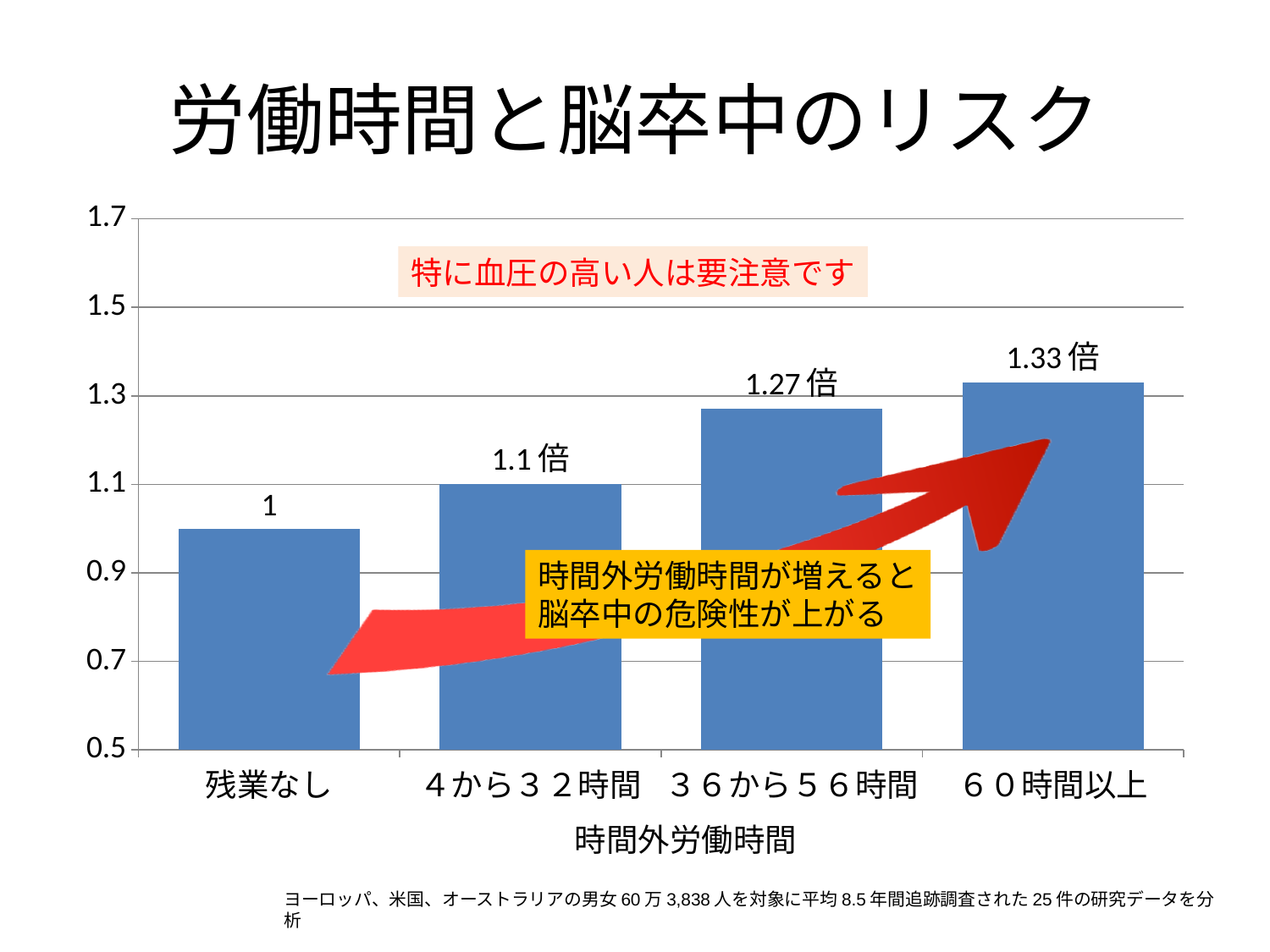
Do the values rise or fall from left to right along the x axis? rise What type of chart is shown on the slide? bar chart What is the title of the x axis? 時間外労働時間 What is the value shown for 残業なし? 1 What is the value shown for ４から３２時間? 1.1倍 Which is larger, the value for ４から３２時間 or the value for ３６から５６時間? ３６から５６時間 What is the value shown for ３６から５６時間? 1.27倍 Which category has the highest value? ６０時間以上 What is the difference between the values for ６０時間以上 and ３６から５６時間? 0.06倍 Which category has the lowest value? 残業なし How many categories are shown on the x axis? 4 What is the value shown for ６０時間以上? 1.33倍